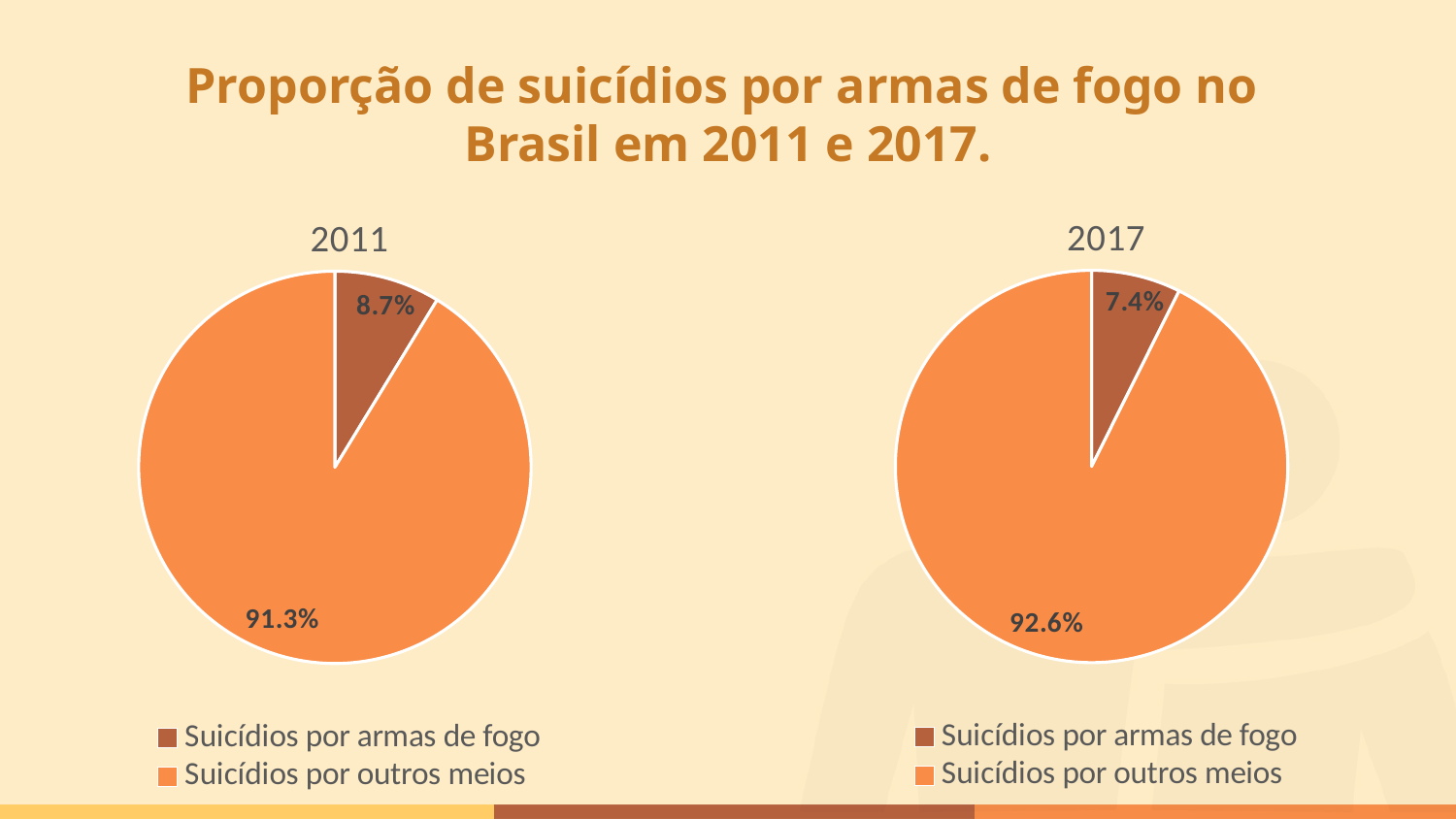
In the 2017 chart, what percentage of suicides were by firearms (Suicídios por armas de fogo)? 7.4% In the 2017 chart, what percentage of suicides were by other means (Suicídios por outros meios)? 92.6% How many entries does the legend of the 2011 chart list? 2 What kind of chart is used for the 2011 data? Pie chart In the 2011 chart, what percentage of suicides were by other means (Suicídios por outros meios)? 91.3% What is the title of the slide containing the two pie charts? Proporção de suicídios por armas de fogo no Brasil em 2011 e 2017. In the 2011 chart, which slice is the largest? Suicídios por outros meios How many slices does the 2017 pie chart have? 2 In the 2017 chart, which slice is the smallest? Suicídios por armas de fogo Which chart shows a larger share for Suicídios por armas de fogo, 2011 or 2017? 2011 What is the difference between the firearm suicide share in 2011 and in 2017? 1.3% In the 2011 chart, what percentage of suicides were by firearms (Suicídios por armas de fogo)? 8.7%